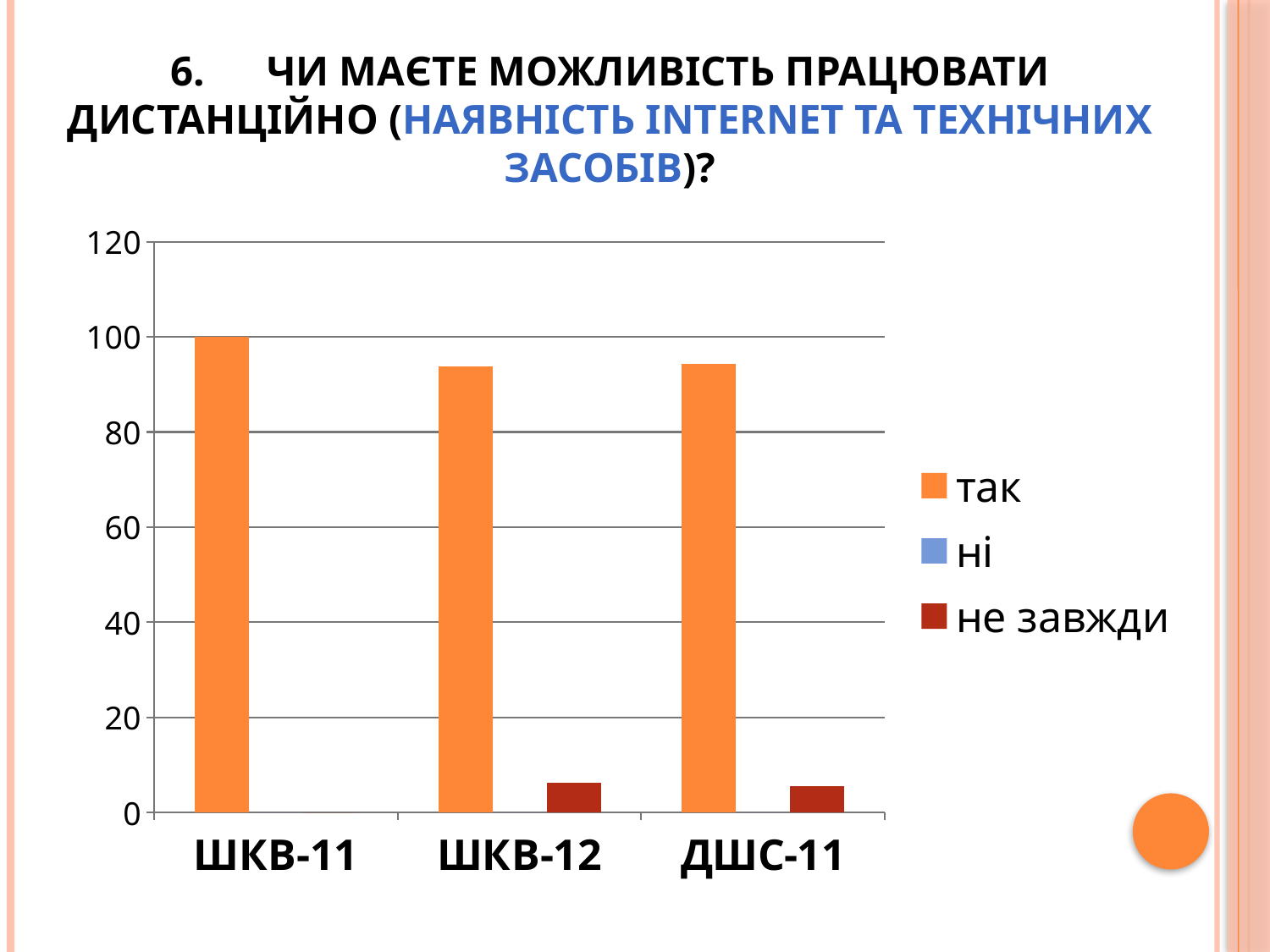
How many series does the legend list? 3 Is the value of "не завжди" for ДШС-11 greater or less than 20? less Which category has the highest value for "так"? ШКВ-11 Which is larger for ШКВ-12: the value of "так" or the value of "не завжди"? так Is the value of "так" for ШКВ-12 greater or less than 80? greater What are the three entries listed in the legend? так, ні, не завжди Is the value of "так" for ДШС-11 greater or less than 100? less Which series is shown in orange in the legend? так How many categories are shown on the x axis? 3 What kind of chart is shown on the slide? bar chart What is the value of "так" for ШКВ-11? 100